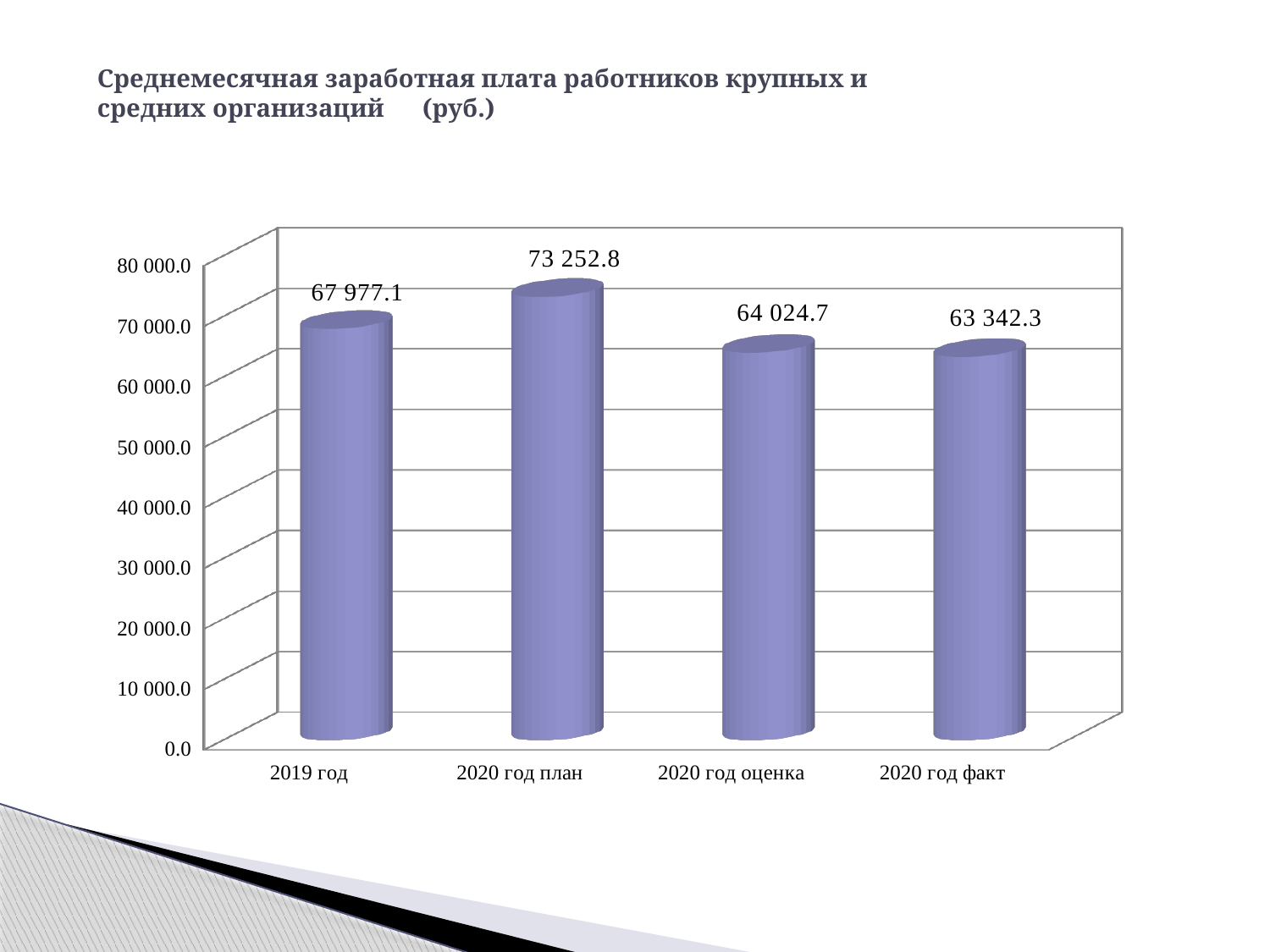
Which is larger, the value for 2019 год or the value for 2020 год оценка? 2019 год Which category has the lowest value? 2020 год факт What is the value for 2020 год оценка? 64 024.7 What is the value for 2020 год план? 73 252.8 What is the difference between the values for 2020 год оценка and 2020 год факт? 682.4 Is the value for 2020 год план greater or less than 70 000.0? greater What is the value for 2020 год факт? 63 342.3 What is the value for 2019 год? 67 977.1 What is the difference between the values for 2020 год план and 2019 год? 5 275.7 Which category has the highest value? 2020 год план What kind of chart is shown on the slide? bar chart How many categories are shown on the x axis? 4